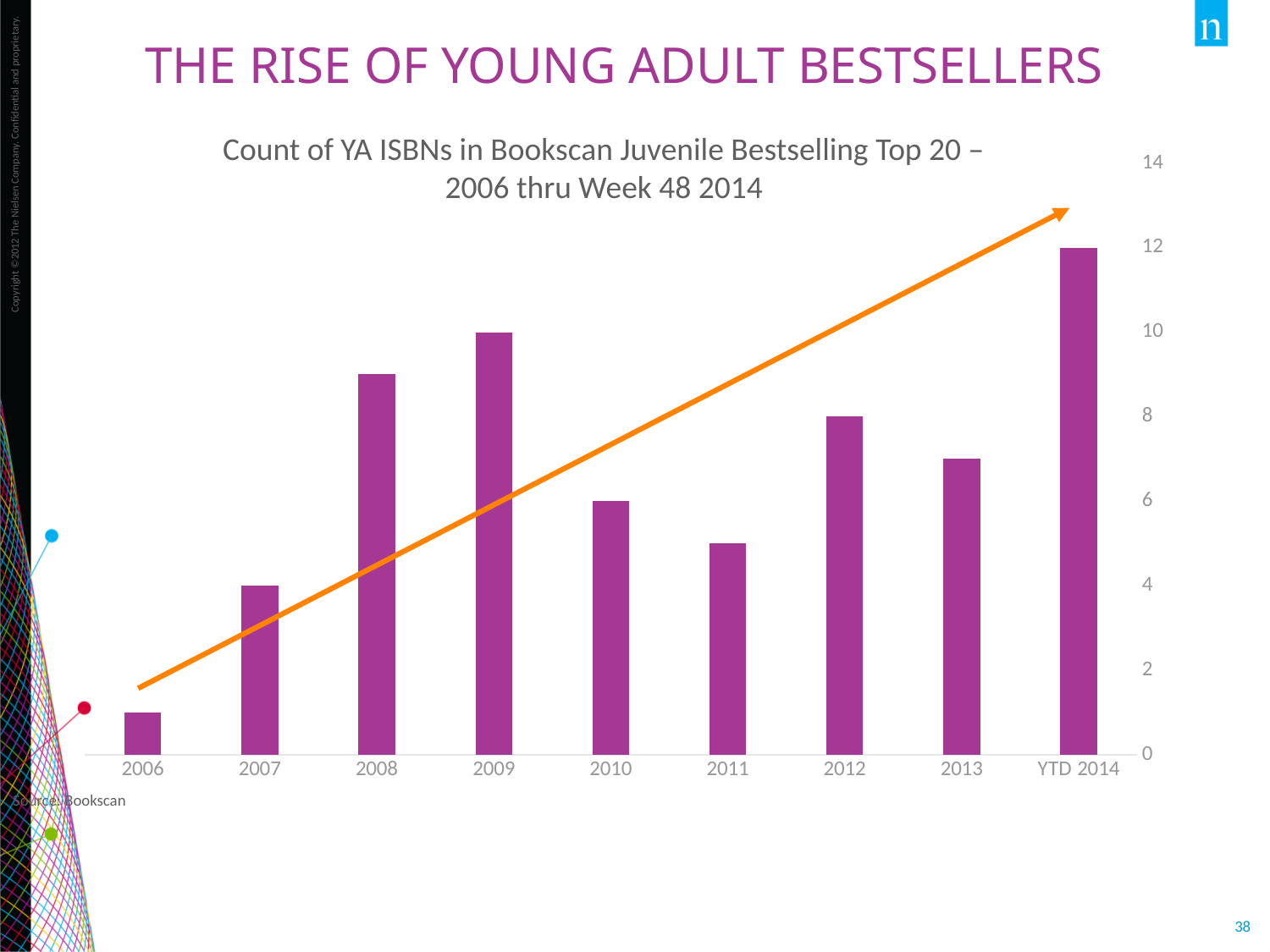
Is the value for 2008 greater or less than 8? greater What type of chart is shown on the slide? Bar chart Which year has the highest count of YA ISBNs in the Bookscan Juvenile Bestselling Top 20? YTD 2014 What is the count of YA ISBNs for 2007? 4 What is the difference between the counts for 2012 and 2010? 2 Which year has a higher count of YA ISBNs, 2008 or 2010? 2008 Is the value for 2013 greater or less than 8? less What is the count of YA ISBNs for 2012? 8 What source is cited for the chart data? Bookscan What is the count of YA ISBNs for YTD 2014? 12 How many years (categories) are shown on the x axis of the chart? 9 Which year has the lowest count of YA ISBNs in the Bookscan Juvenile Bestselling Top 20? 2006